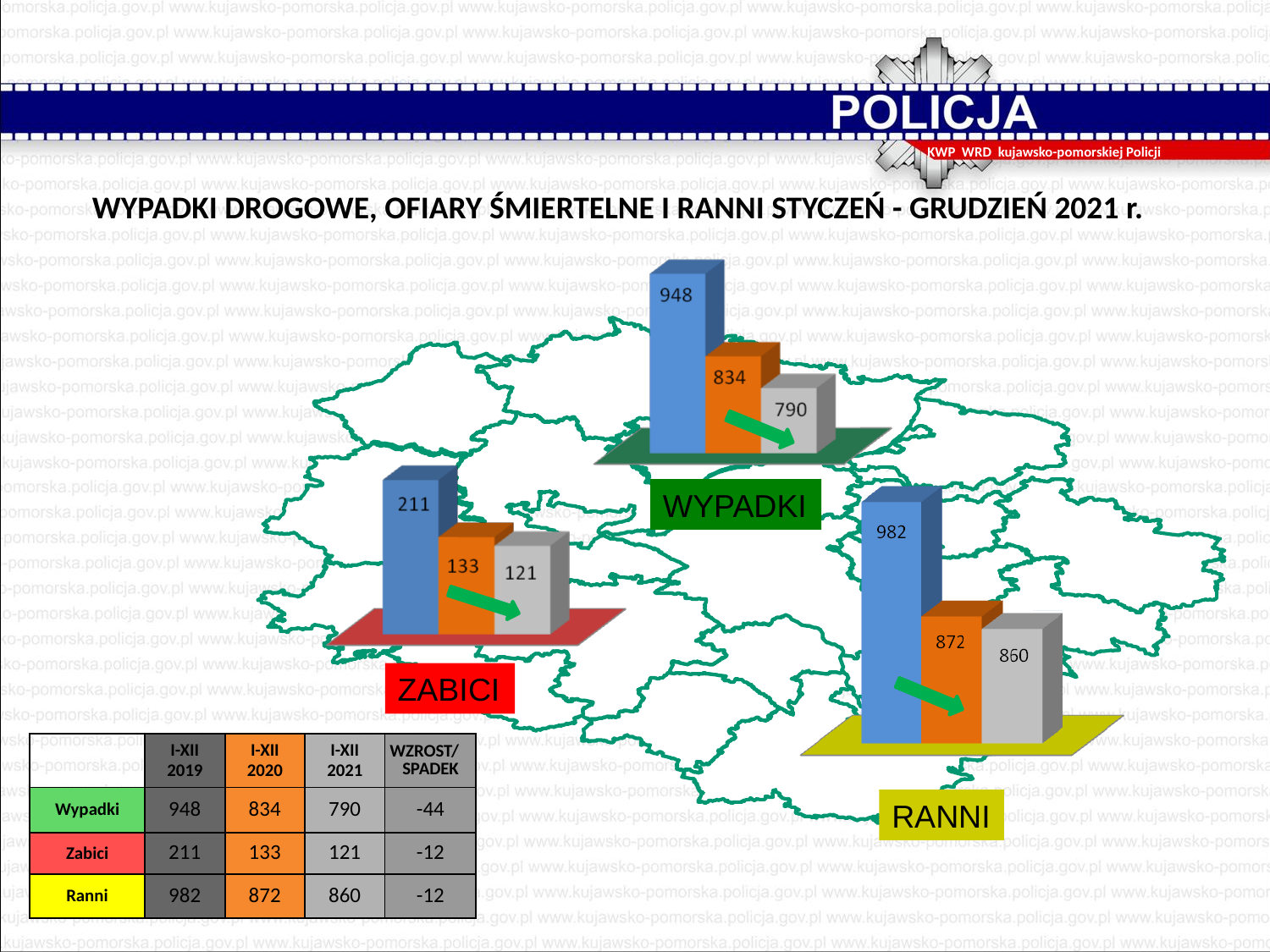
In the WYPADKI chart, what is the value of the tallest (blue) bar? 948 In the WYPADKI chart, what is the difference between the blue bar (948) and the grey bar (790)? 158 Which is larger: the grey bar in the WYPADKI chart or the grey bar in the RANNI chart? The grey bar in the RANNI chart (860) In the RANNI chart, which bar is the highest? The blue bar (982) How many bars does the ZABICI chart show? 3 How many separate bar charts are shown on the map? 3 In the RANNI chart, do the values rise or fall from the blue bar to the grey bar? Fall In the ZABICI chart, which bar is the lowest? The grey bar (121) In the RANNI chart, what is the value of the orange bar? 872 What kind of chart is the WYPADKI chart? Bar chart In the ZABICI chart, what is the value of the grey bar? 121 In the ZABICI chart, what is the difference between the orange bar (133) and the grey bar (121)? 12